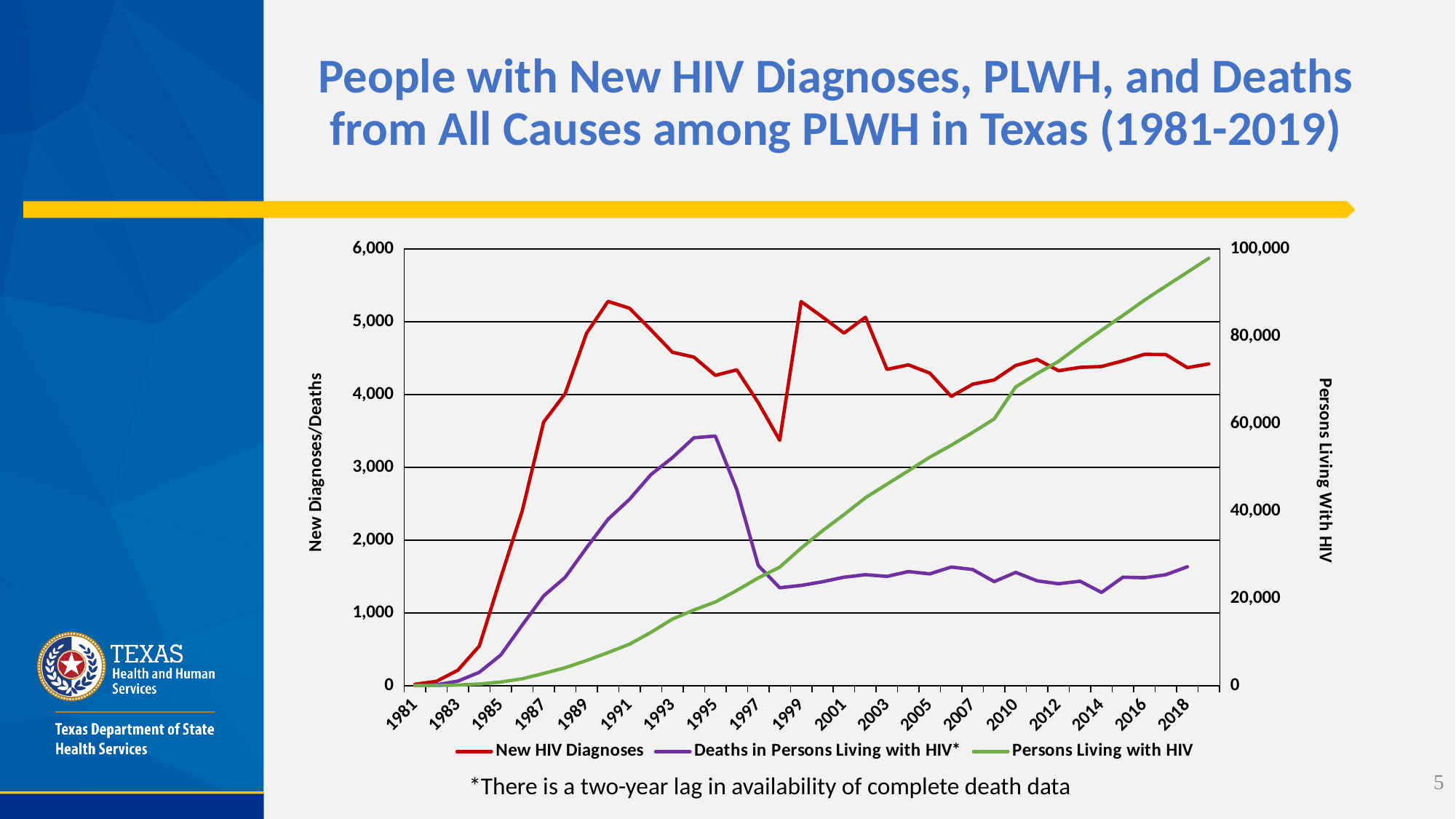
What are the three series named in the legend? New HIV Diagnoses; Deaths in Persons Living with HIV*; Persons Living with HIV How many series does the legend list? 3 Is the value for Deaths in Persons Living with HIV in 1995 greater or less than 3,000? greater Is the value for New HIV Diagnoses in 1998 greater or less than 4,000? less Is the value for Deaths in Persons Living with HIV in 2014 greater or less than 2,000? less Does the Persons Living with HIV line rise or fall from 1981 to the end of the period? rises In 1995, which is higher on the left axis: New HIV Diagnoses or Deaths in Persons Living with HIV? New HIV Diagnoses Does the Deaths in Persons Living with HIV line rise or fall between 1995 and 1997? falls What type of chart is shown on the slide? line chart What is the title of the left vertical axis? New Diagnoses/Deaths